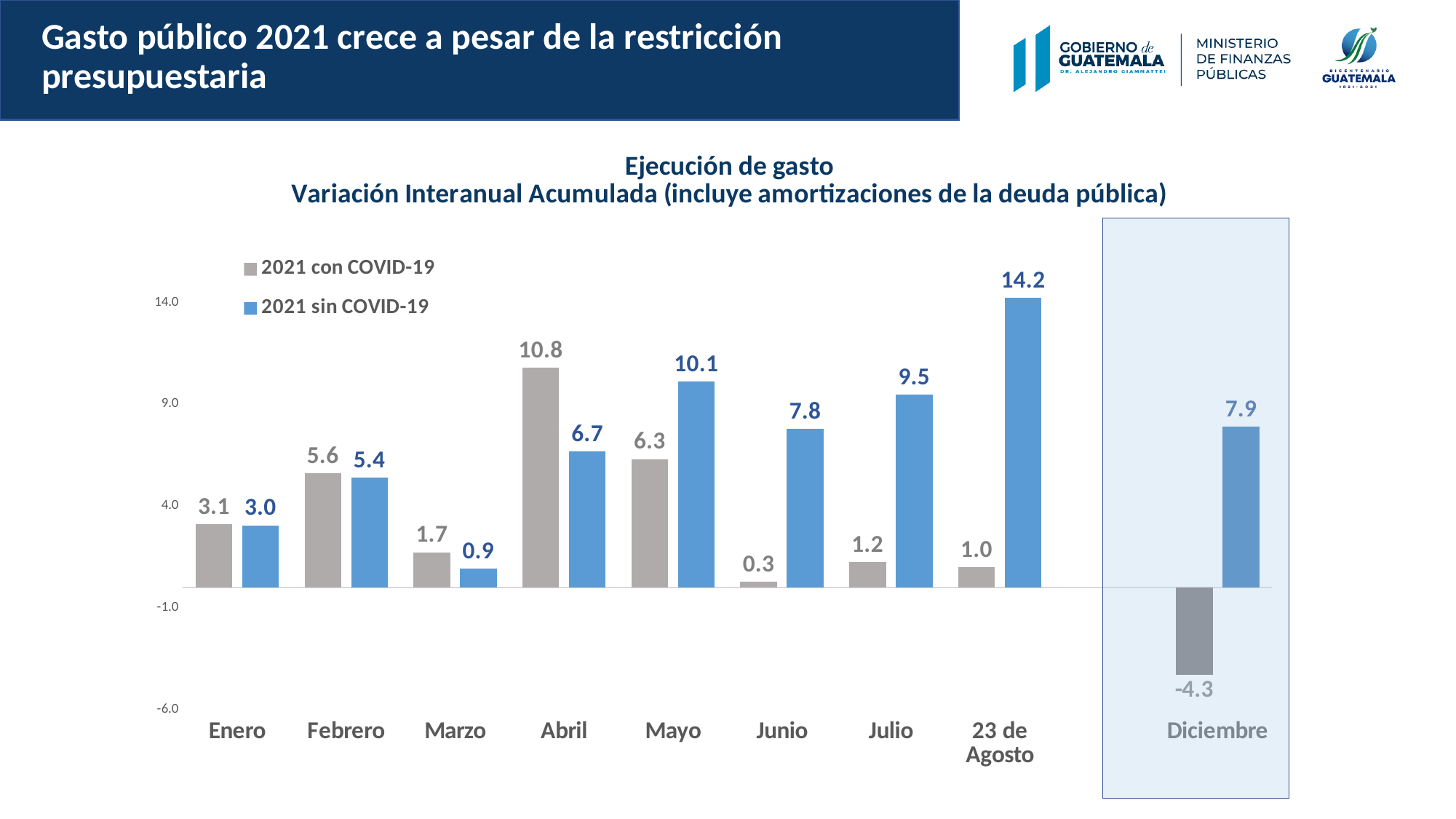
How many categories are shown on the x axis? 9 What is the value for Diciembre in the 2021 con COVID-19 series? -4.3 What is the value for Mayo in the 2021 sin COVID-19 series? 10.1 What is the value for Abril in the 2021 con COVID-19 series? 10.8 Which is larger for Abril: the 2021 con COVID-19 value or the 2021 sin COVID-19 value? 2021 con COVID-19 What is the difference between the 2021 sin COVID-19 and 2021 con COVID-19 values for 23 de Agosto? 13.2 Which category has the highest value in the 2021 sin COVID-19 series? 23 de Agosto How many series does the legend list? 2 Which category has the lowest value in the 2021 con COVID-19 series? Diciembre Is the 2021 sin COVID-19 value for Julio greater or less than 9.0? greater What kind of chart is shown on the slide? bar chart Which series is shown in blue? 2021 sin COVID-19